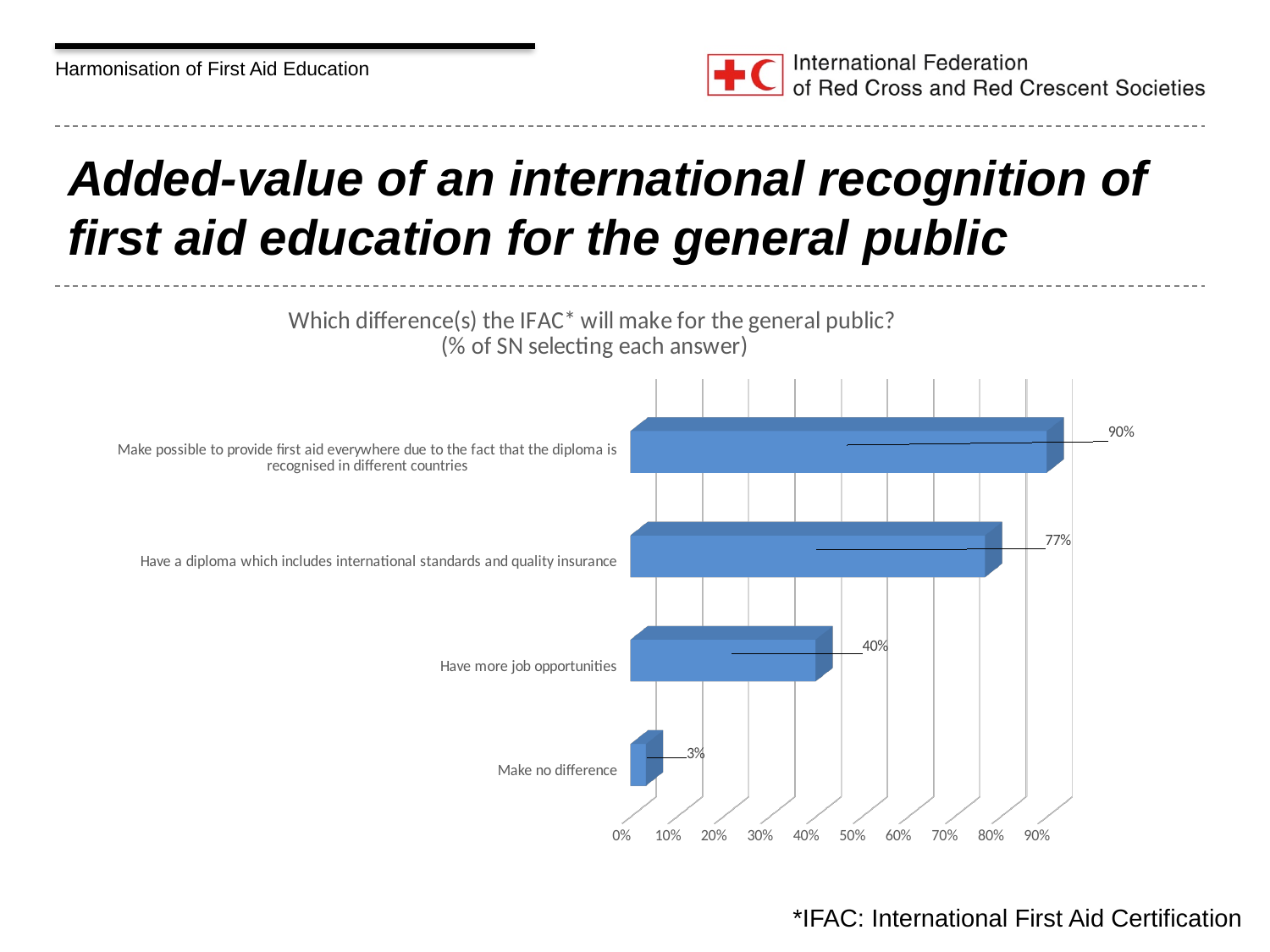
Which answer was selected by the lowest percentage of SN? Make no difference Which answer was selected by the highest percentage of SN? Make possible to provide first aid everywhere due to the fact that the diploma is recognised in different countries What percentage of SN selected "Make no difference"? 3% What percentage of SN selected "Have more job opportunities"? 40% What is the title of the chart? Which difference(s) the IFAC* will make for the general public? (% of SN selecting each answer) What percentage of SN selected "Have a diploma which includes international standards and quality insurance"? 77% Which was selected by more SN: "Have more job opportunities" or "Have a diploma which includes international standards and quality insurance"? Have a diploma which includes international standards and quality insurance What is the difference in percentage points between "Make possible to provide first aid everywhere..." (90%) and "Have a diploma which includes international standards and quality insurance" (77%)? 13 percentage points What kind of chart is shown on the slide? Bar chart Is the value for "Have more job opportunities" greater or less than 50%? less What is the difference in percentage points between "Have more job opportunities" and "Make no difference"? 37 percentage points How many answer options are shown in the chart? 4